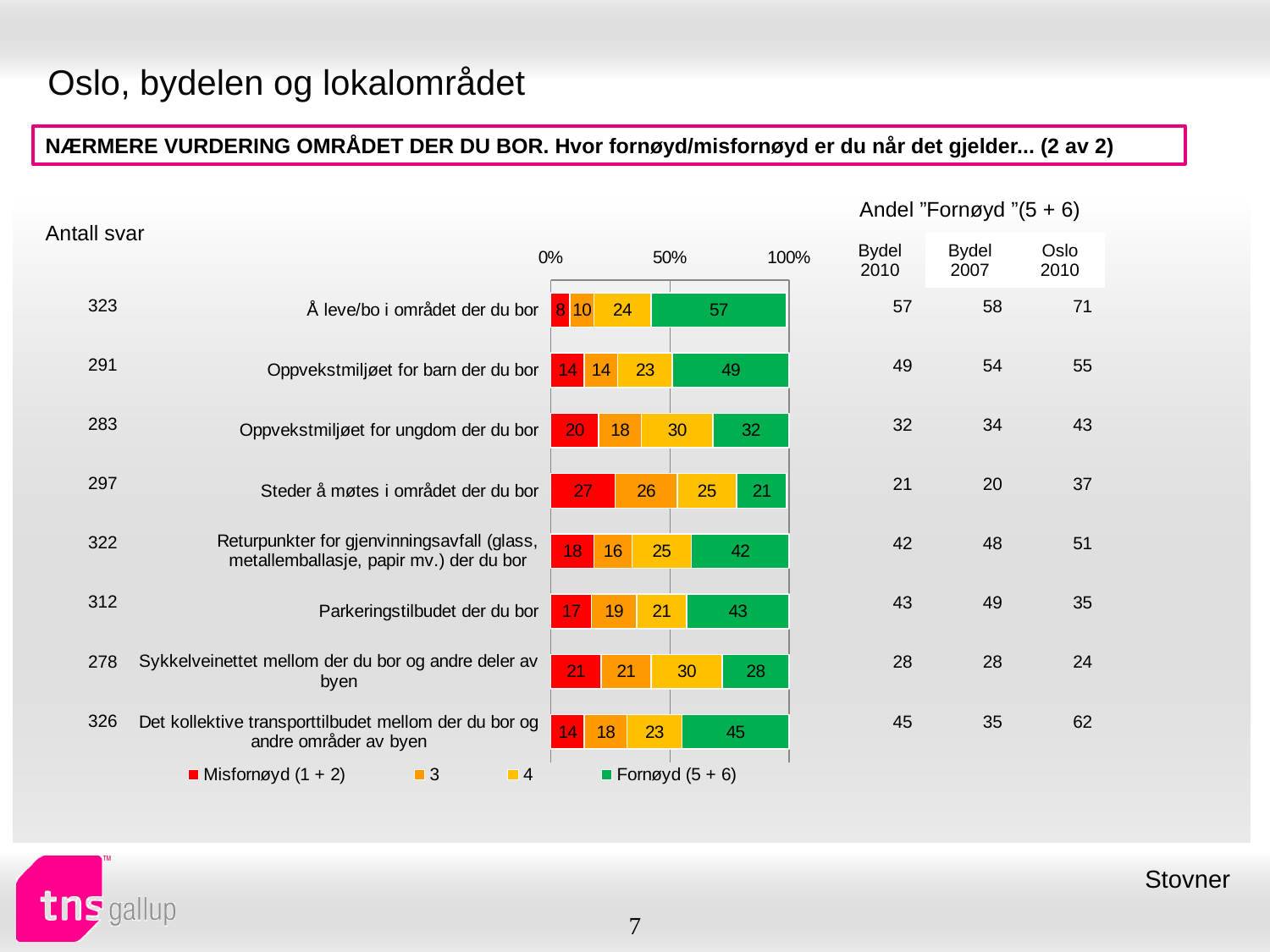
What is the Misfornøyd (1 + 2) value for "Steder å møtes i området der du bor"? 27 How many series does the legend list? 4 What is the value of series "4" for "Sykkelveinettet mellom der du bor og andre deler av byen"? 30 What is the total of the stacked bar for "Oppvekstmiljøet for ungdom der du bor"? 100 Which has a larger Fornøyd (5 + 6) value: "Oppvekstmiljøet for barn der du bor" or "Det kollektive transporttilbudet mellom der du bor og andre områder av byen"? Oppvekstmiljøet for barn der du bor How many categories are shown in the bar chart? 8 What kind of chart is shown on the slide? Stacked bar chart What is the difference between the Fornøyd (5 + 6) values for "Parkeringstilbudet der du bor" and "Oppvekstmiljøet for ungdom der du bor"? 11 Which category has the lowest Fornøyd (5 + 6) value? Steder å møtes i området der du bor What is the Fornøyd (5 + 6) value for "Å leve/bo i området der du bor"? 57 Which category has the highest Fornøyd (5 + 6) value? Å leve/bo i området der du bor Which category has the lowest Misfornøyd (1 + 2) value? Å leve/bo i området der du bor